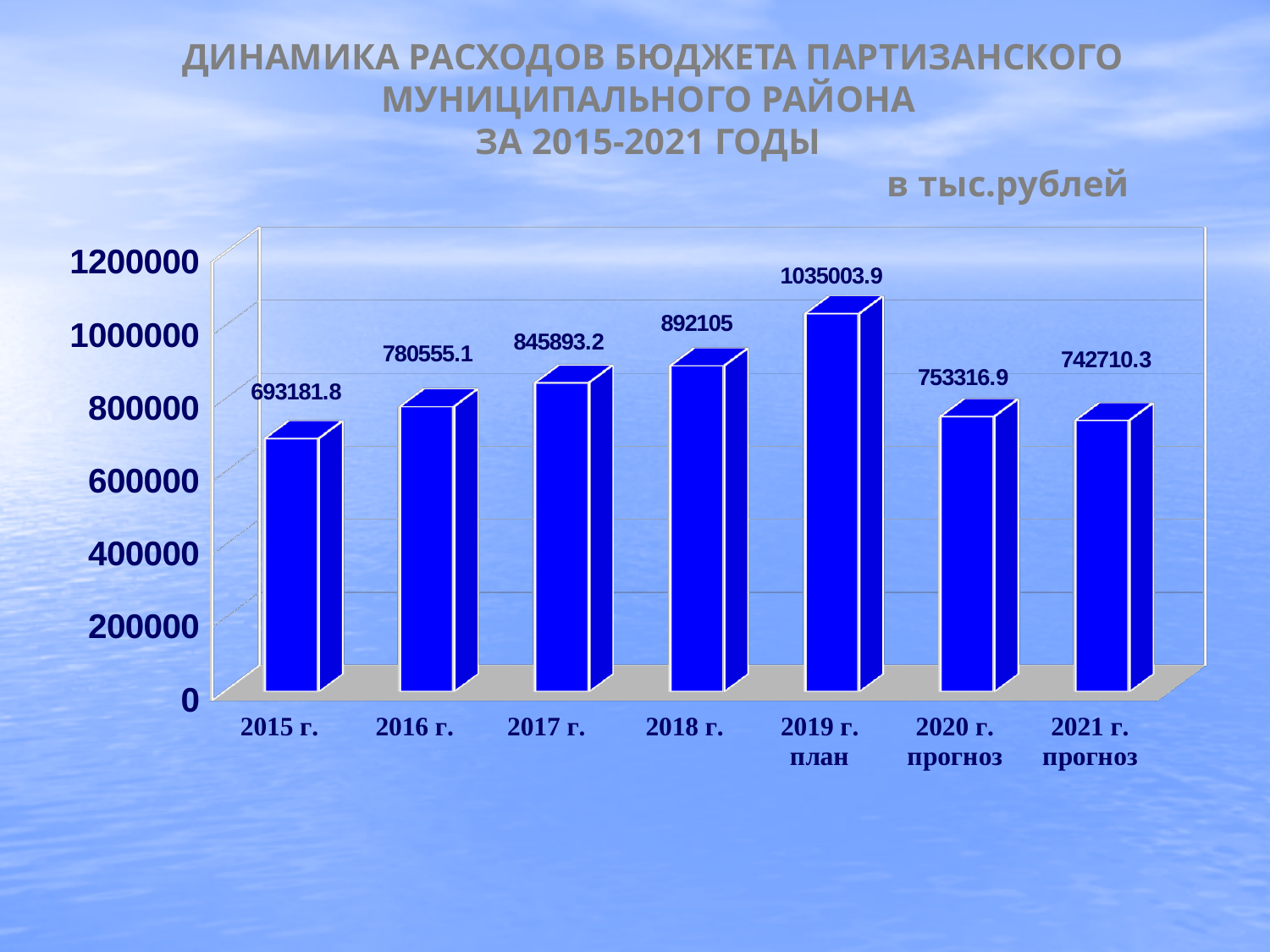
What is the value for 2019 г. план? 1035003.9 What is the value for 2021 г. прогноз? 742710.3 Is the value for 2019 г. план greater or less than 1000000? greater Do the values rise or fall from 2015 г. to 2019 г. план? rise Which is larger, the value for 2016 г. or the value for 2020 г. прогноз? 2016 г. Which year has the lowest value? 2015 г. How many years are shown on the x axis? 7 What is the value for 2015 г.? 693181.8 What is the difference between the values for 2019 г. план and 2015 г.? 341822.1 Which year has the highest value? 2019 г. план What kind of chart is shown on the slide? bar chart What is the difference between the values for 2018 г. and 2017 г.? 46211.8